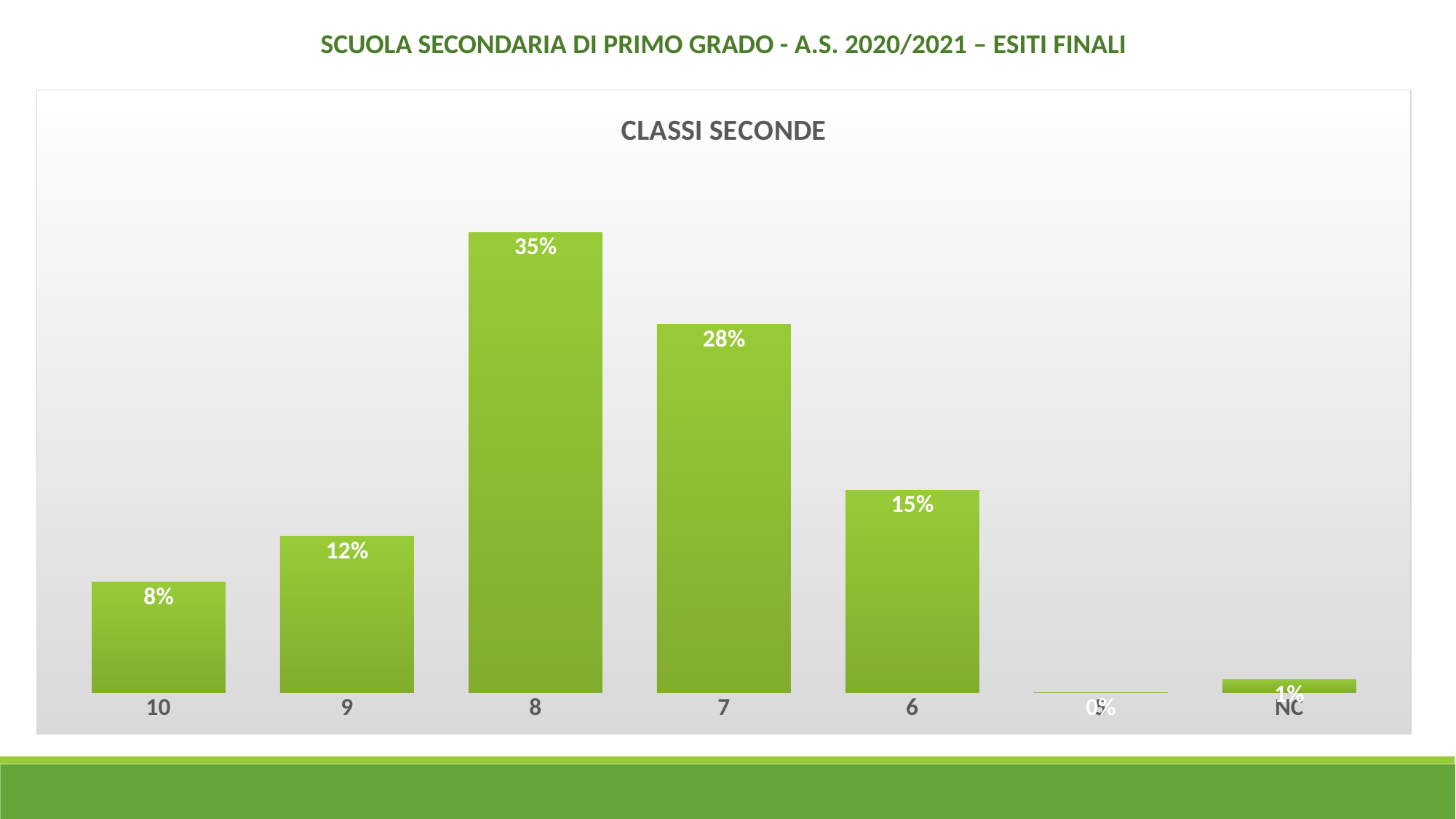
What type of chart is shown on the slide? bar chart What is the value for category 6? 15% Which is larger, the value for category 7 or the value for category 6? 7 What is the difference between the values for category 9 and category 10? 4% What is the value for category 10? 8% What is the value for category 9? 12% What is the title of the chart? CLASSI SECONDE What is the value for category NC? 1% Which category has the highest value? 8 What is the value for category 8? 35% What is the difference between the values for category 8 and category 7? 7% How many categories are shown on the x axis? 7